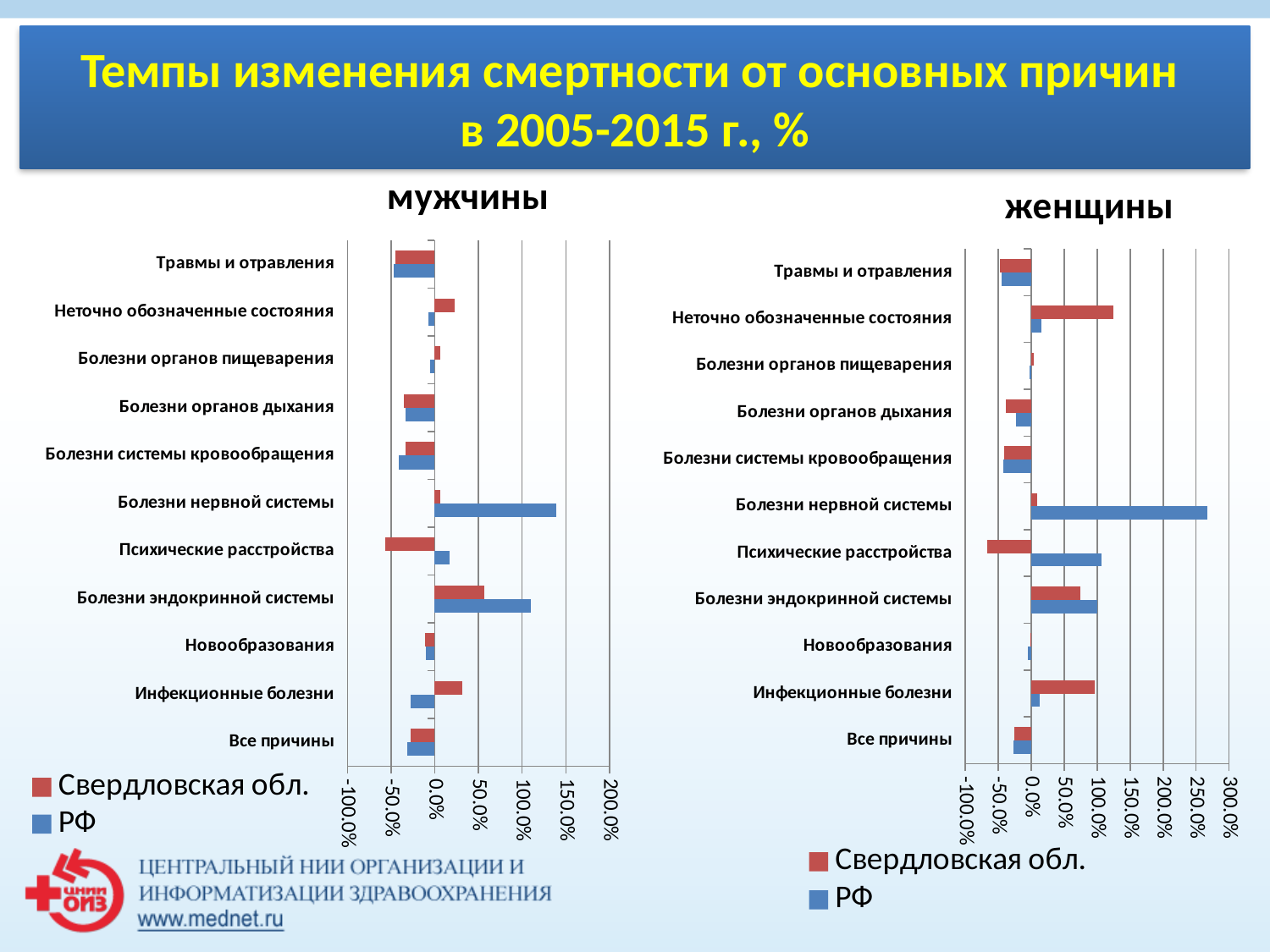
How many categories are plotted on the "женщины" chart? 11 On the "мужчины" chart, which category has the highest value for Свердловская обл.? Болезни эндокринной системы How many series does the legend of the "мужчины" chart list? 2 On the "мужчины" chart, which category has the lowest value for Свердловская обл.? Психические расстройства On the "мужчины" chart, which colour represents РФ in the legend? blue On the "мужчины" chart, which category has the highest value for РФ? Болезни нервной системы On the "женщины" chart, for Неточно обозначенные состояния, which series has the larger value: Свердловская обл. or РФ? Свердловская обл. On the "женщины" chart, which category has the lowest value for Свердловская обл.? Психические расстройства On the "женщины" chart, which category has the highest value for РФ? Болезни нервной системы On the "женщины" chart, is the РФ value for Болезни нервной системы greater or less than 200.0%? greater What kind of chart is the "мужчины" chart? bar chart On the "мужчины" chart, is the РФ value for Болезни нервной системы greater or less than 100.0%? greater